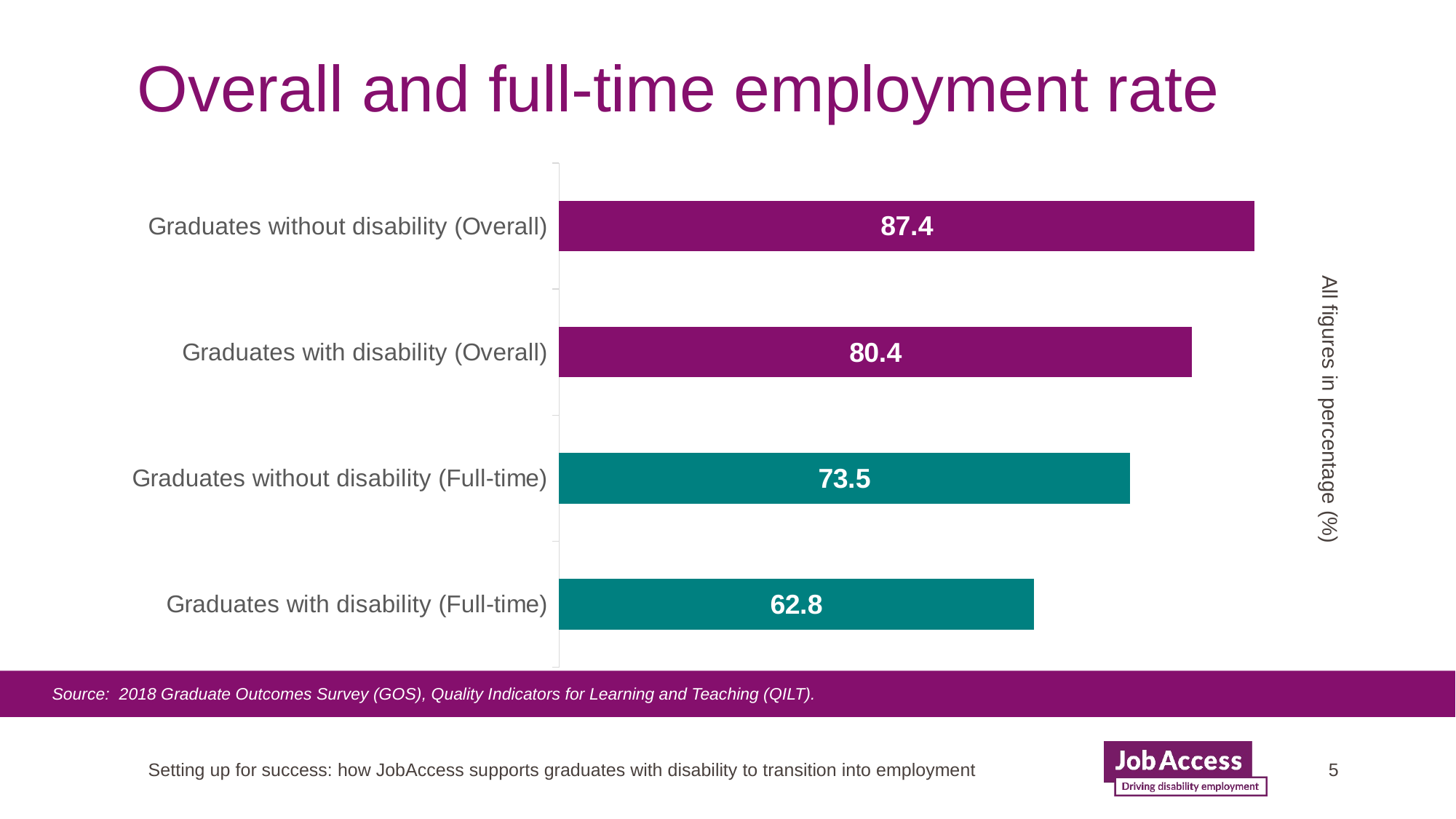
What is the value for Graduates without disability (Full-time)? 73.5 What is the title of the chart? Overall and full-time employment rate How many categories are shown in the chart? 4 What is the value for Graduates with disability (Overall)? 80.4 What is the value for Graduates without disability (Overall)? 87.4 What kind of chart is shown on the slide? Bar chart What is the difference between Graduates without disability (Full-time) and Graduates with disability (Full-time)? 10.7 Which is larger: the value for Graduates with disability (Overall) or Graduates without disability (Full-time)? Graduates with disability (Overall) What is the difference between Graduates without disability (Overall) and Graduates with disability (Overall)? 7.0 Which category has the highest value? Graduates without disability (Overall) Which category has the lowest value? Graduates with disability (Full-time) What is the value for Graduates with disability (Full-time)? 62.8